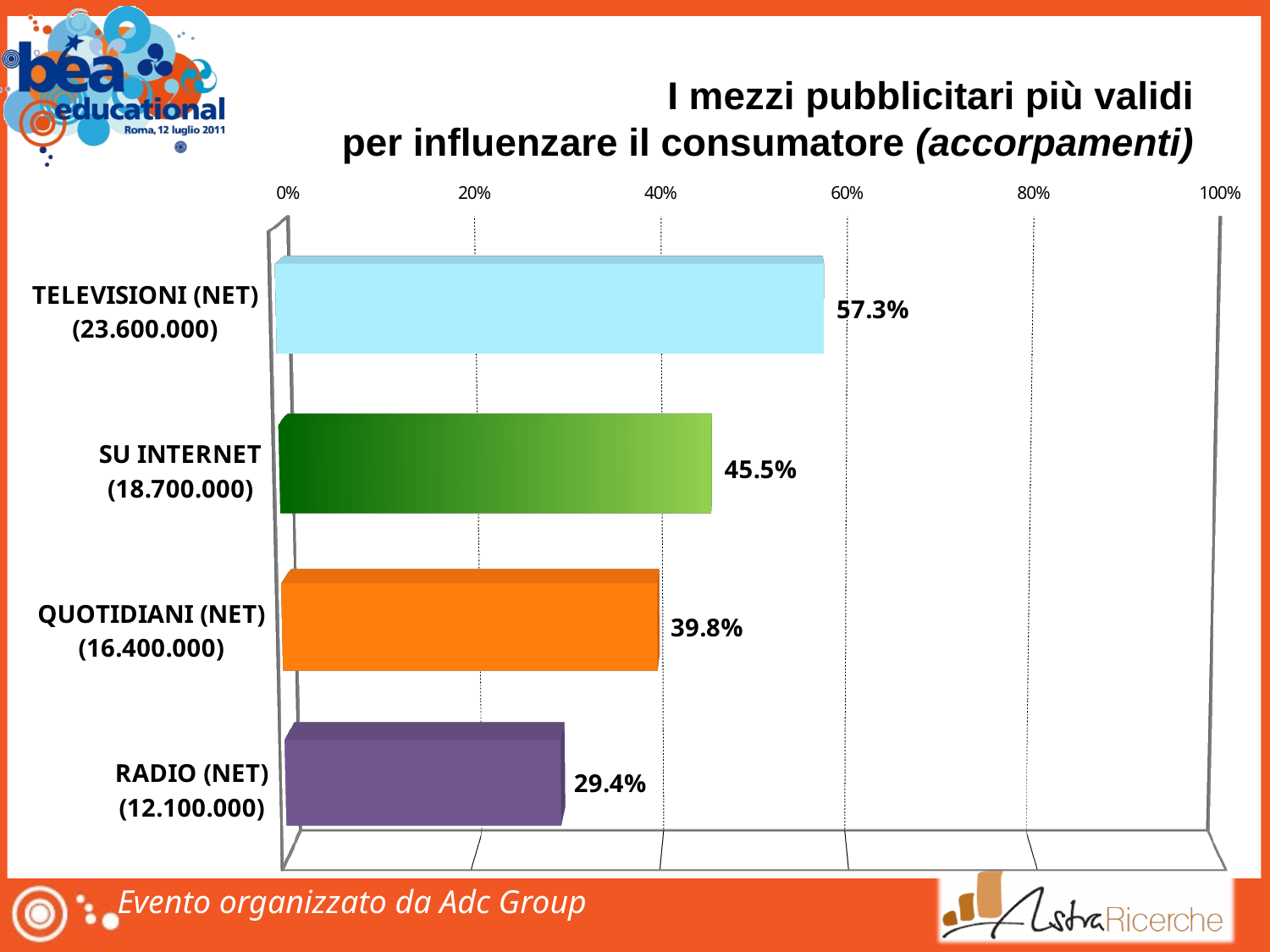
Is the value for RADIO (NET) greater or less than 40%? less Which category has the lowest value? RADIO (NET) What is the value for TELEVISIONI (NET)? 57.3% Which category has the highest value? TELEVISIONI (NET) Which is larger, the value for SU INTERNET or the value for QUOTIDIANI (NET)? SU INTERNET What is the value for RADIO (NET)? 29.4% What is the value for QUOTIDIANI (NET)? 39.8% What is the value for SU INTERNET? 45.5% How many categories are shown in the chart? 4 What is the difference between the values for QUOTIDIANI (NET) and RADIO (NET)? 10.4% What is the difference between the values for TELEVISIONI (NET) and SU INTERNET? 11.8% What kind of chart is shown on the slide? bar chart